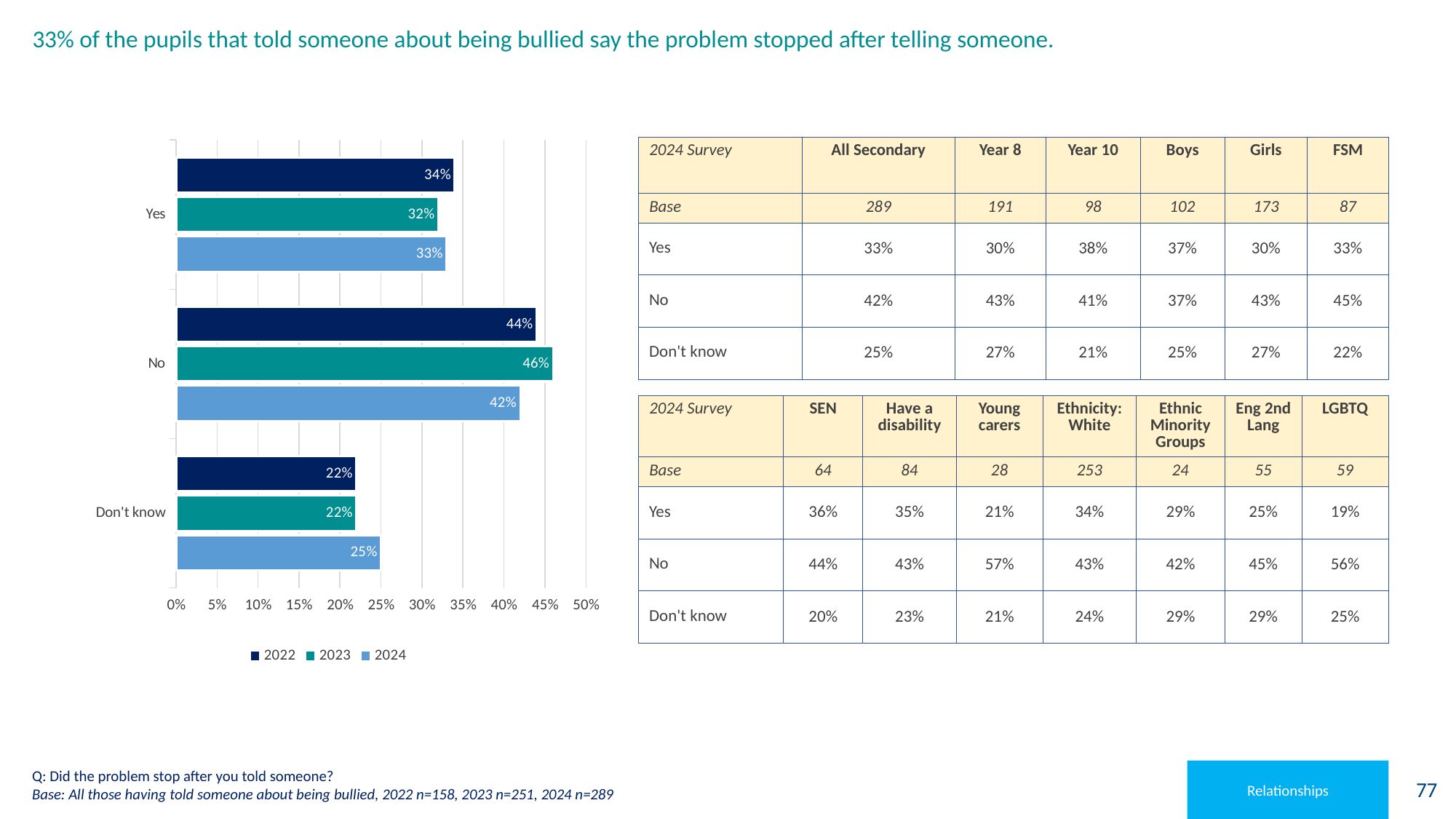
What is the difference between the 2023 and 2024 values for 'No'? 4% What is the value for 'Don't know' in the 2022 series? 22% How many series does the legend list? 3 How many categories are shown on the chart? 3 Which category has the highest value in the 2024 series? No What is the value for 'Yes' in the 2024 series? 33% Which is larger: the 2022 value for 'Yes' or the 2023 value for 'Yes'? 2022 Which series is shown in the darkest blue colour? 2022 What kind of chart is shown on the slide? Bar chart Is the 2022 value for 'No' greater or less than 40%? greater What is the value for 'No' in the 2023 series? 46% Which category has the lowest value in the 2023 series? Don't know